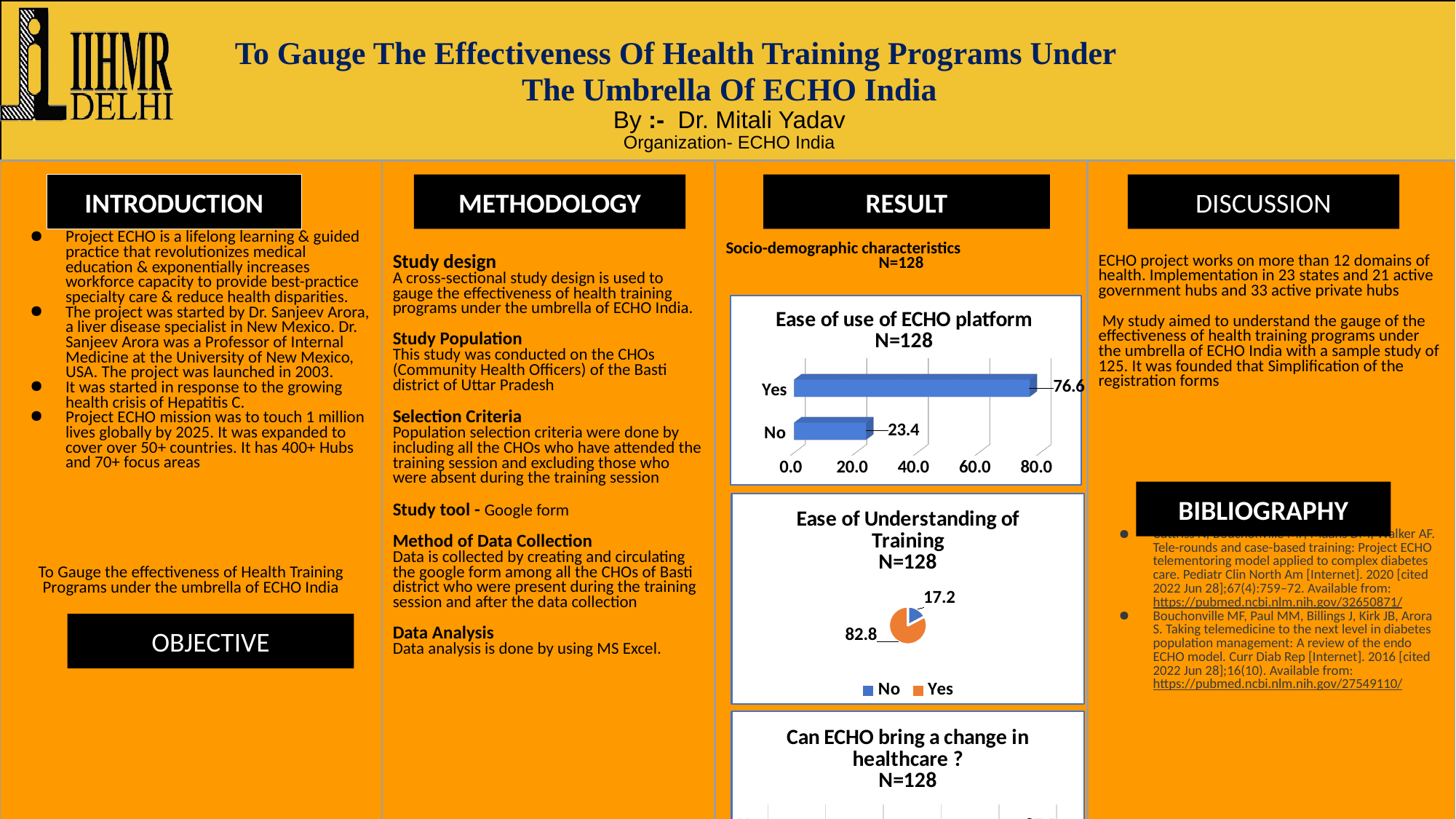
In the 'Ease of Understanding of Training' chart, what is the value for Yes? 82.8 In the 'Ease of Understanding of Training' chart, what is the value for No? 17.2 What kind of chart is the 'Ease of use of ECHO platform' chart? Bar chart In the 'Ease of use of ECHO platform' chart, what is the difference between the Yes and No values? 53.2 What kind of chart is the 'Ease of Understanding of Training' chart? Pie chart In the 'Ease of use of ECHO platform' chart, is the value for No greater or less than 40.0? less In the 'Ease of use of ECHO platform' chart, what is the value for Yes? 76.6 In the 'Ease of Understanding of Training' chart, which colour represents Yes? Orange How many entries does the legend of the 'Ease of Understanding of Training' chart list? 2 In the 'Ease of use of ECHO platform' chart, which category has the highest value? Yes In the 'Ease of use of ECHO platform' chart, what is the value for No? 23.4 How many categories are shown in the 'Ease of use of ECHO platform' chart? 2